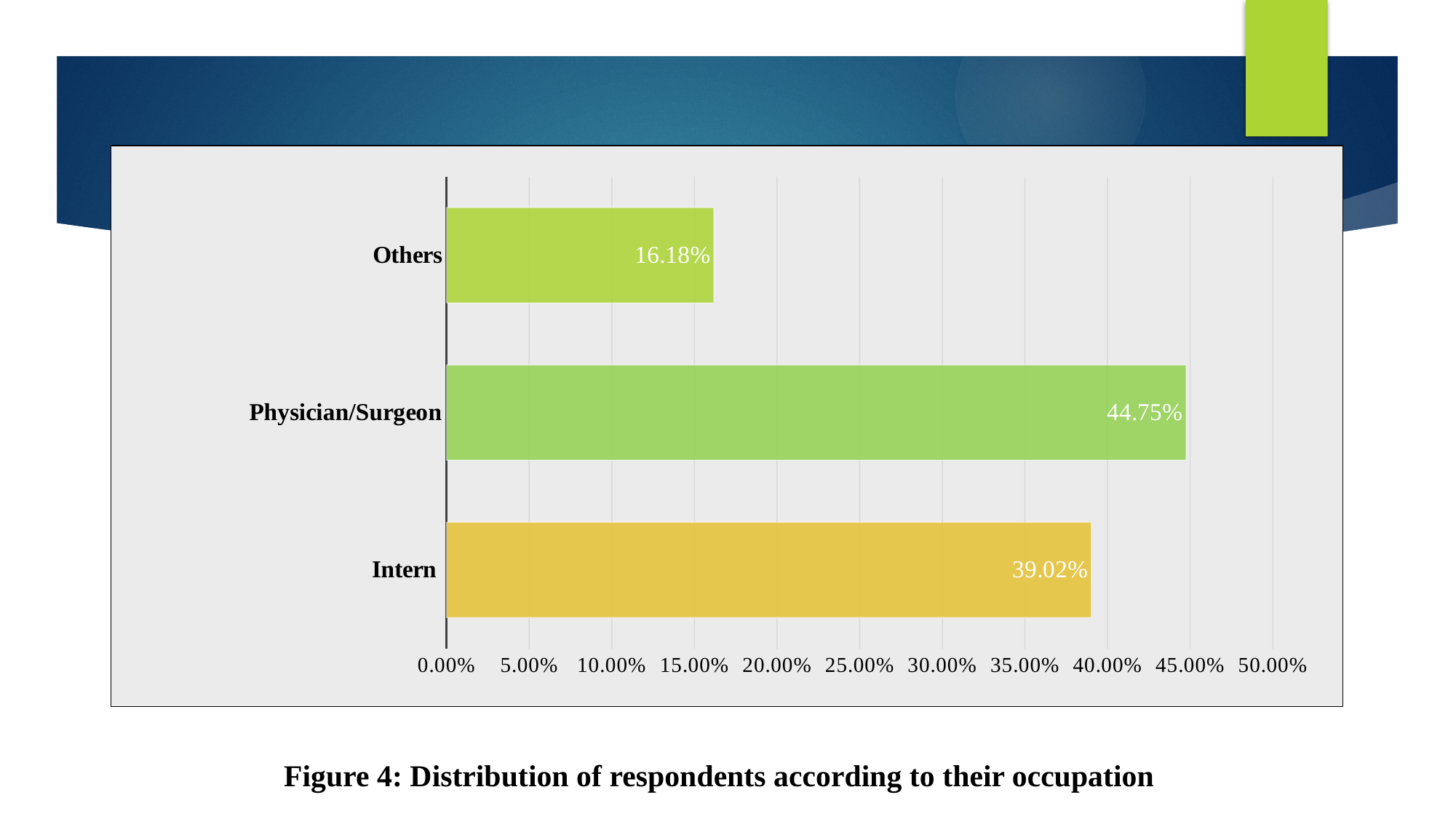
What is the difference between the Physician/Surgeon and Intern percentages? 5.73% What percentage of respondents are Physician/Surgeon? 44.75% What percentage of respondents fall under Others? 16.18% Which is larger, the value for Intern or the value for Others? Intern How many occupation categories are shown in the chart? 3 Which occupation category has the highest share of respondents? Physician/Surgeon Is the value for Physician/Surgeon greater or less than 40.00%? greater What is the caption of the figure on the slide? Figure 4: Distribution of respondents according to their occupation What percentage of respondents are Intern? 39.02% Which occupation category has the lowest share of respondents? Others What type of chart is shown on the slide? Bar chart What is the difference between the Intern and Others percentages? 22.84%